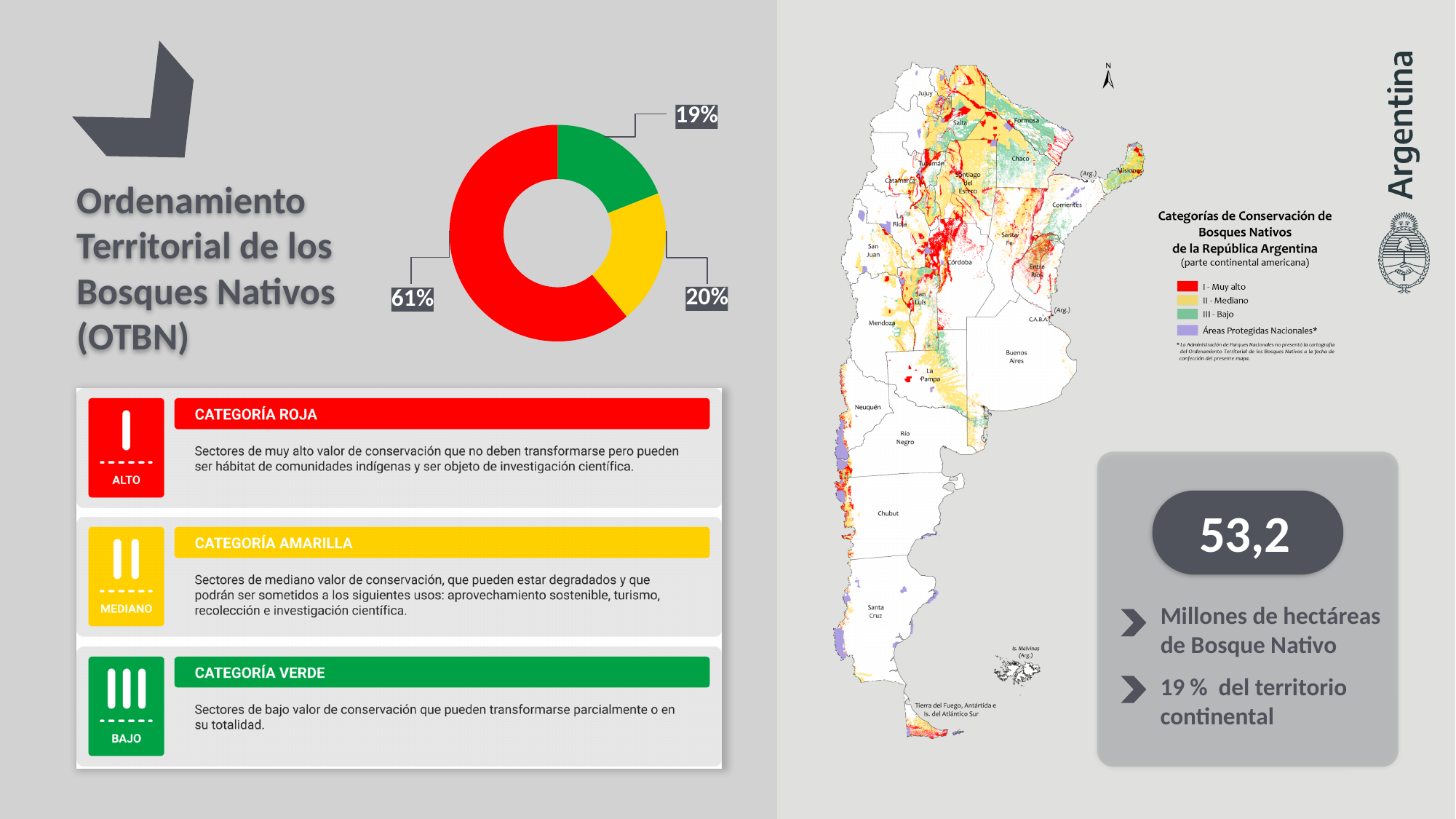
Which colour slice is the smallest in the donut chart? Green In the donut chart, what percentage does the red slice represent? 61% How many slices does the donut chart have? 3 Which colour slice is the largest in the donut chart? Red What is the difference in percentage points between the yellow slice and the green slice in the donut chart? 1 Which colour in the donut chart corresponds to Categoría Roja (Alto) according to the slide? Red In the donut chart, what percentage does the yellow slice represent? 20% In the donut chart, what percentage does the green slice represent? 19% What is the combined percentage of the yellow and green slices in the donut chart? 39% What is the difference in percentage points between the red slice and the yellow slice in the donut chart? 41 What kind of chart is shown on the left side of the slide? Donut (pie) chart Is the red slice of the donut chart greater or less than 50%? greater